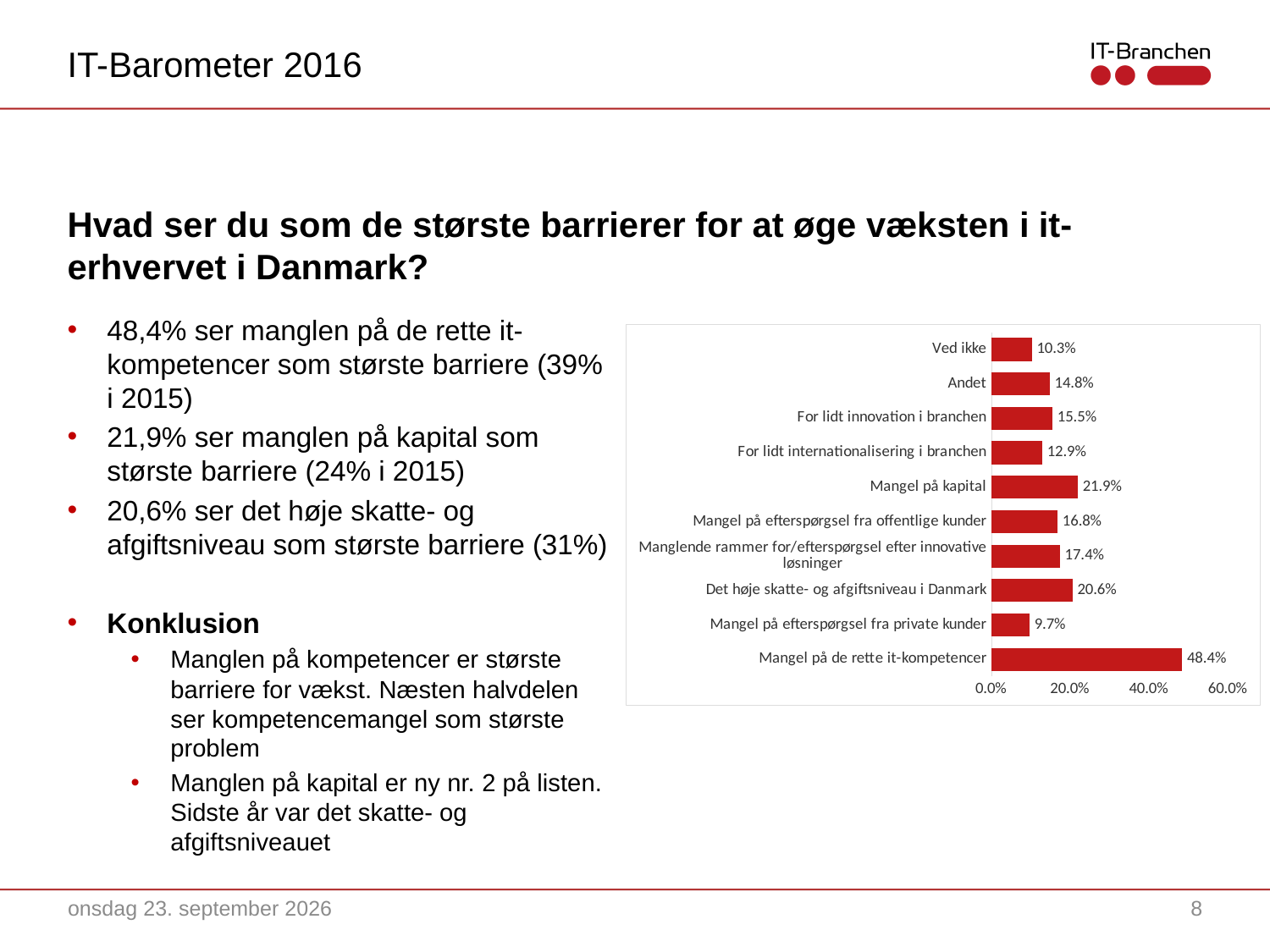
What is the value for "Det høje skatte- og afgiftsniveau i Danmark"? 20.6% Is the value for "Mangel på kapital" greater or less than 20.0%? greater Which is larger: the value for "Mangel på efterspørgsel fra offentlige kunder" or for "Andet"? Mangel på efterspørgsel fra offentlige kunder Which category has the lowest value? Mangel på efterspørgsel fra private kunder What is the value for "Mangel på de rette it-kompetencer"? 48.4% Which category has the highest value? Mangel på de rette it-kompetencer What kind of chart is shown on the slide? Bar chart What is the value for "Mangel på kapital"? 21.9% What is the difference between the values for "Mangel på de rette it-kompetencer" and "Mangel på kapital"? 26.5 percentage points How many categories are shown in the chart? 10 What is the value for "For lidt internationalisering i branchen"? 12.9% What is the value for "Ved ikke"? 10.3%